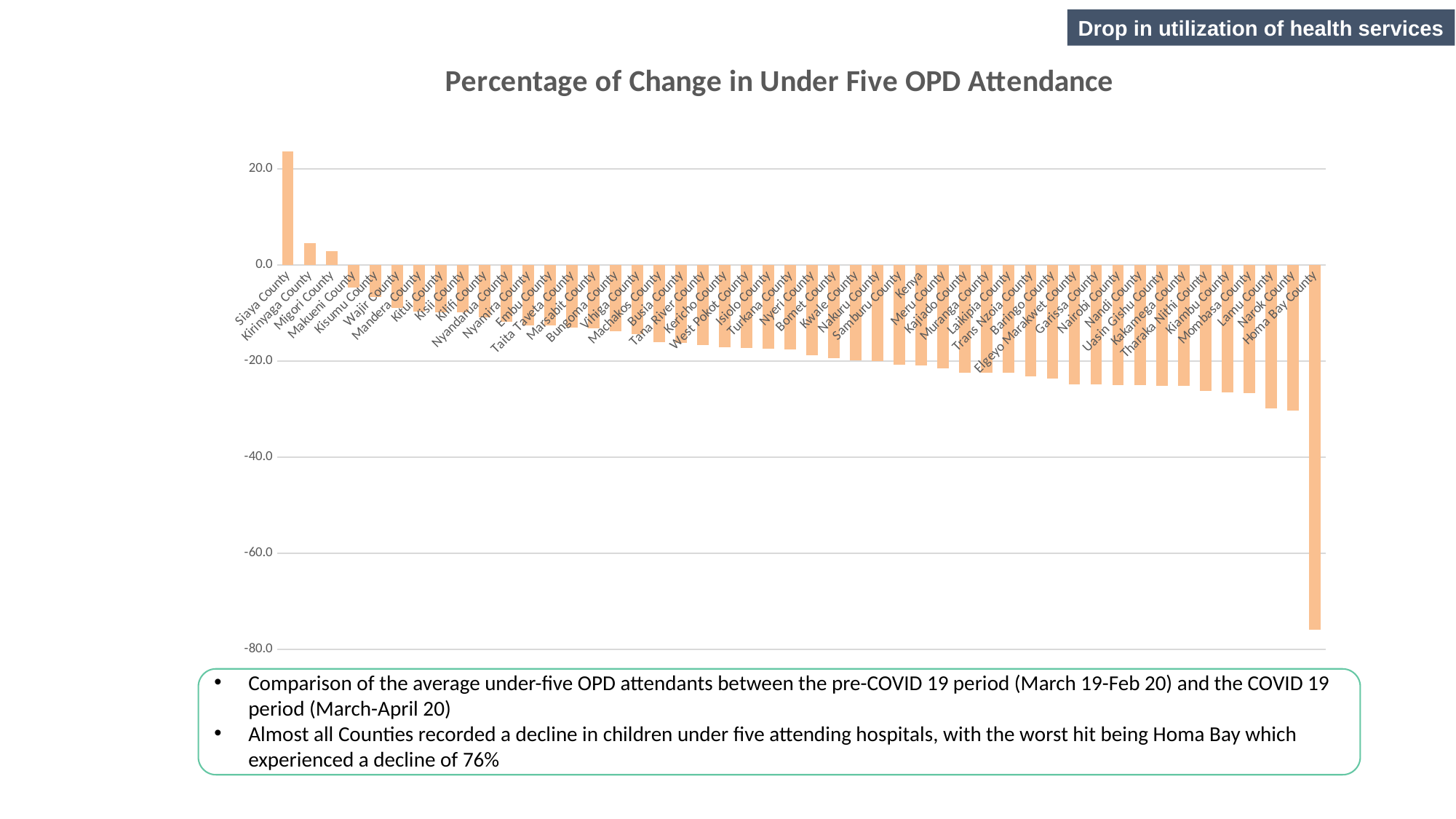
Is the value for Siaya County greater or less than 20.0? greater Is the value for Narok County greater or less than -20.0? less Which county has the highest percentage change in under five OPD attendance? Siaya County Which has the larger value, Siaya County or Kirinyaga County? Siaya County Is the value for Kisumu County greater or less than -20.0? greater How many counties show a positive percentage change (bars above 0.0)? 3 According to the slide text, what decline in under five OPD attendance did Homa Bay experience? 76% Do the values generally rise or fall moving from left to right along the x axis? Fall What is the title of the chart? Percentage of Change in Under Five OPD Attendance Which county has the lowest percentage change in under five OPD attendance? Homa Bay County What kind of chart is shown on the slide? Bar chart